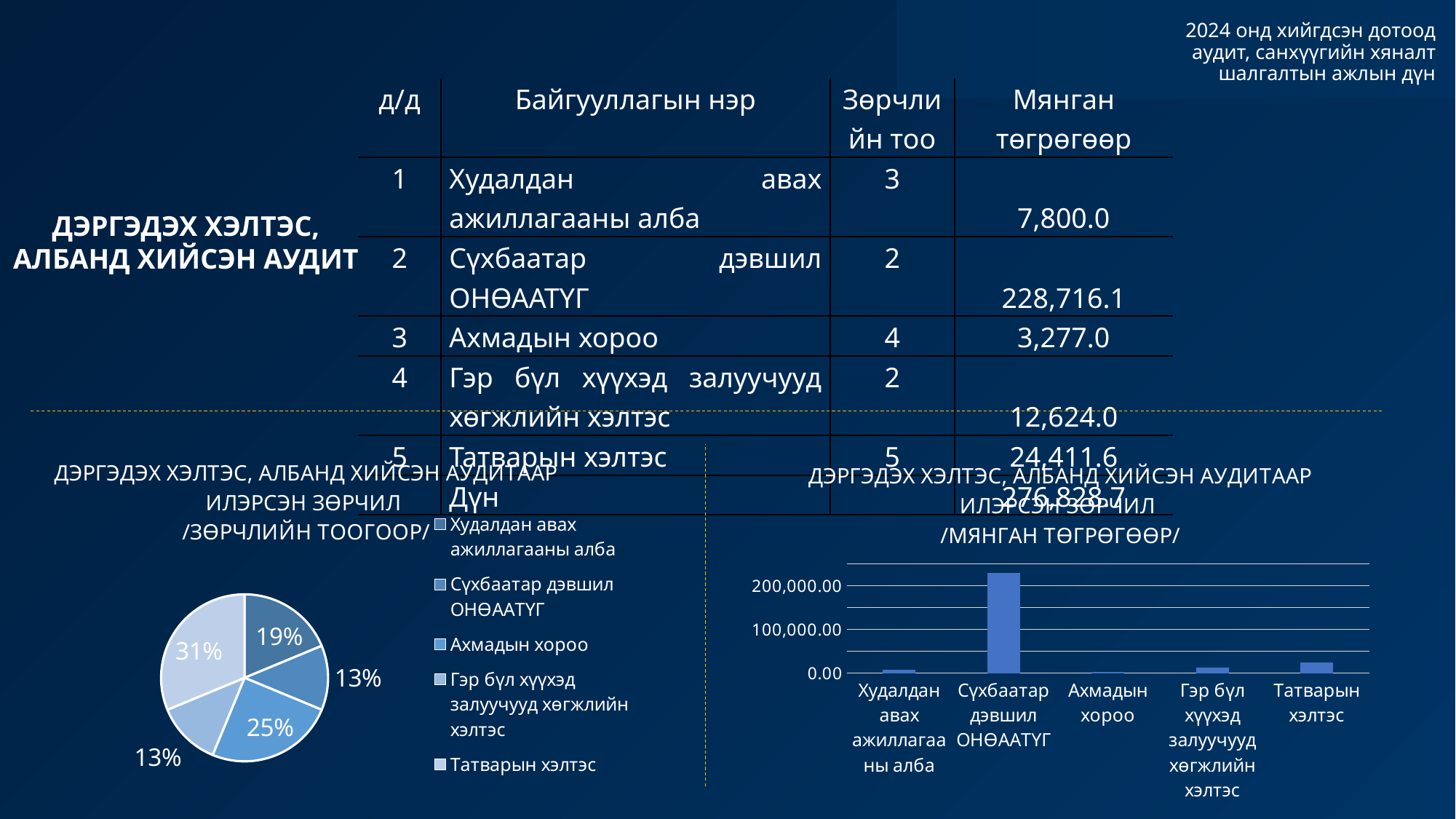
In the bar chart on the right, which category has the highest value? Сүхбаатар дэвшил ОНӨААТҮГ In the bar chart on the right, is the value for Сүхбаатар дэвшил ОНӨААТҮГ greater or less than 200,000.00? greater In the pie chart on the left, what share is shown for Ахмадын хороо? 25% In the pie chart on the left, what is the largest share shown? 31% How many entries does the legend of the pie chart on the left list? 5 In the bar chart on the right, is the value for Татварын хэлтэс greater or less than 100,000.00? less What kind of chart is the chart on the right of the slide (/МЯНГАН ТӨГРӨГӨӨР/)? bar chart How many slices does the pie chart on the left have? 5 How many categories are shown on the x axis of the bar chart on the right? 5 In the pie chart on the left, what share is shown for Худалдан авах ажиллагааны алба? 19% In the pie chart on the left, what share is shown for Татварын хэлтэс? 31% What kind of chart is the chart on the left of the slide (/ЗӨРЧЛИЙН ТООГООР/)? pie chart